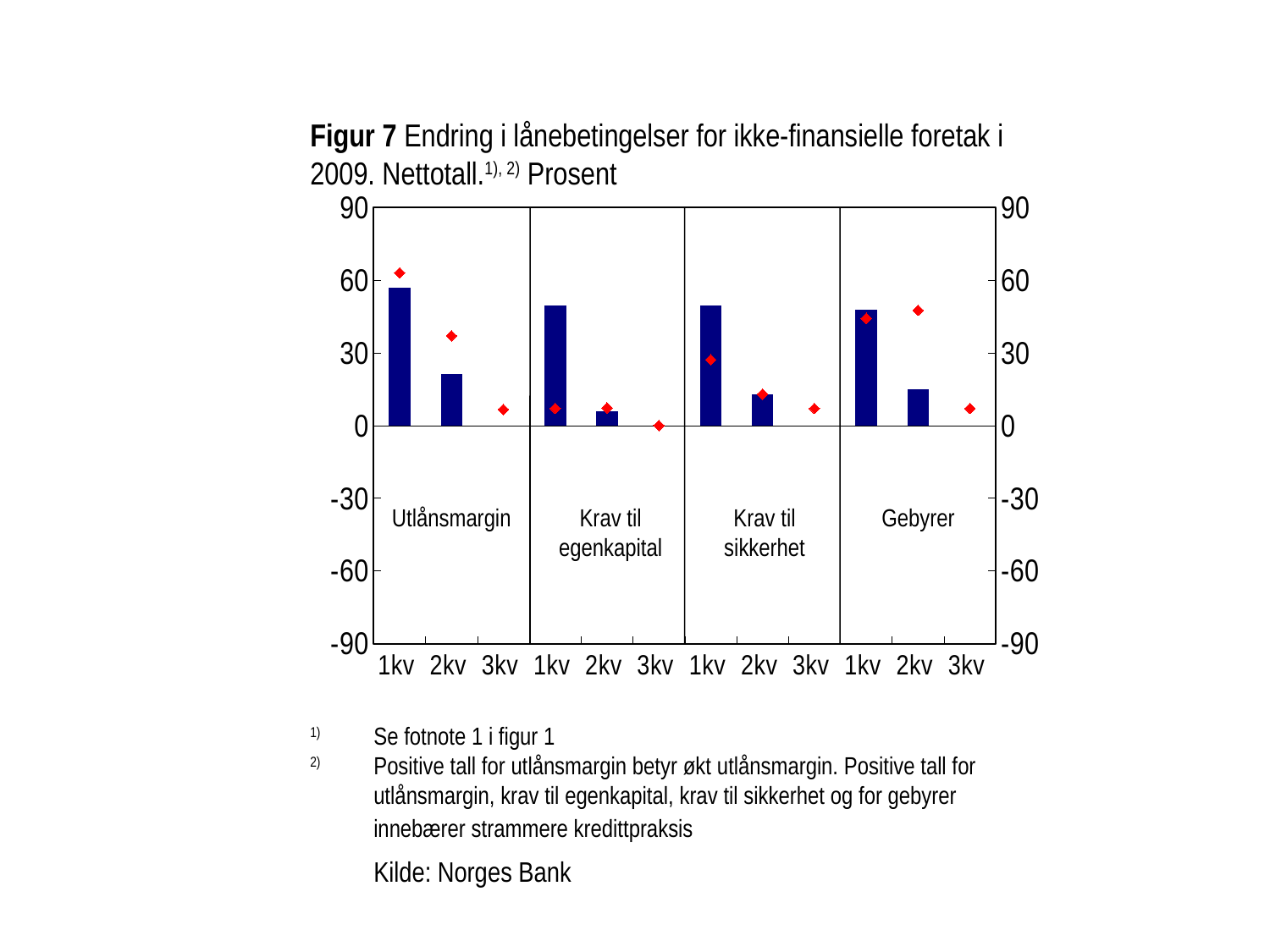
How many categories (panels) are shown along the x axis of the chart? 4 Is the bar for 2kv in the Gebyrer panel greater or less than 30? less Is the bar for 1kv in the Krav til egenkapital panel greater or less than 30? greater Is the bar for 1kv in the Utlånsmargin panel greater or less than 30? greater Which is larger: the 1kv bar for Utlånsmargin or the 1kv bar for Gebyrer? Utlånsmargin Within the Utlånsmargin panel, do the bars rise or fall from 1kv to 3kv? fall What kind of chart is shown in Figur 7? combination bar and line chart (bars with diamond markers) What source is cited below the chart? Norges Bank How many quarters (1kv, 2kv, 3kv) are shown within each panel of the chart? 3